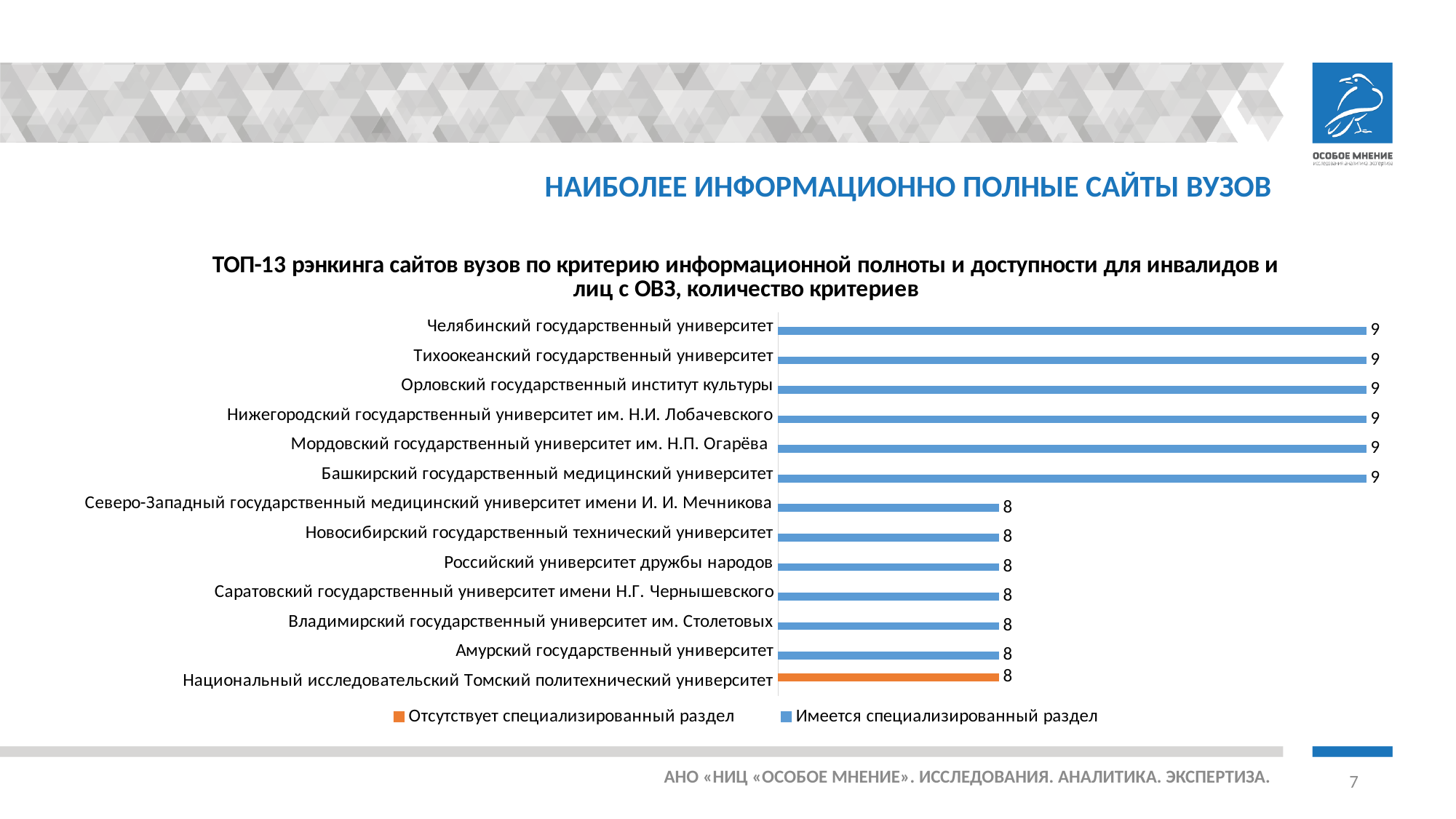
What is the highest value shown in the chart? 9 What is the value for Национальный исследовательский Томский политехнический университет? 8 Which university's bar belongs to the series 'Отсутствует специализированный раздел'? Национальный исследовательский Томский политехнический университет What is the value for Башкирский государственный медицинский университет? 9 Which has a larger value: Тихоокеанский государственный университет or Новосибирский государственный технический университет? Тихоокеанский государственный университет What is the lowest value shown in the chart? 8 How many series does the legend list? 2 How many universities are listed in the chart? 13 What type of chart is shown on the slide? bar chart What is the difference between the value for Мордовский государственный университет им. Н.П. Огарёва and the value for Амурский государственный университет? 1 What is the value for Челябинский государственный университет? 9 What is the value for Российский университет дружбы народов? 8